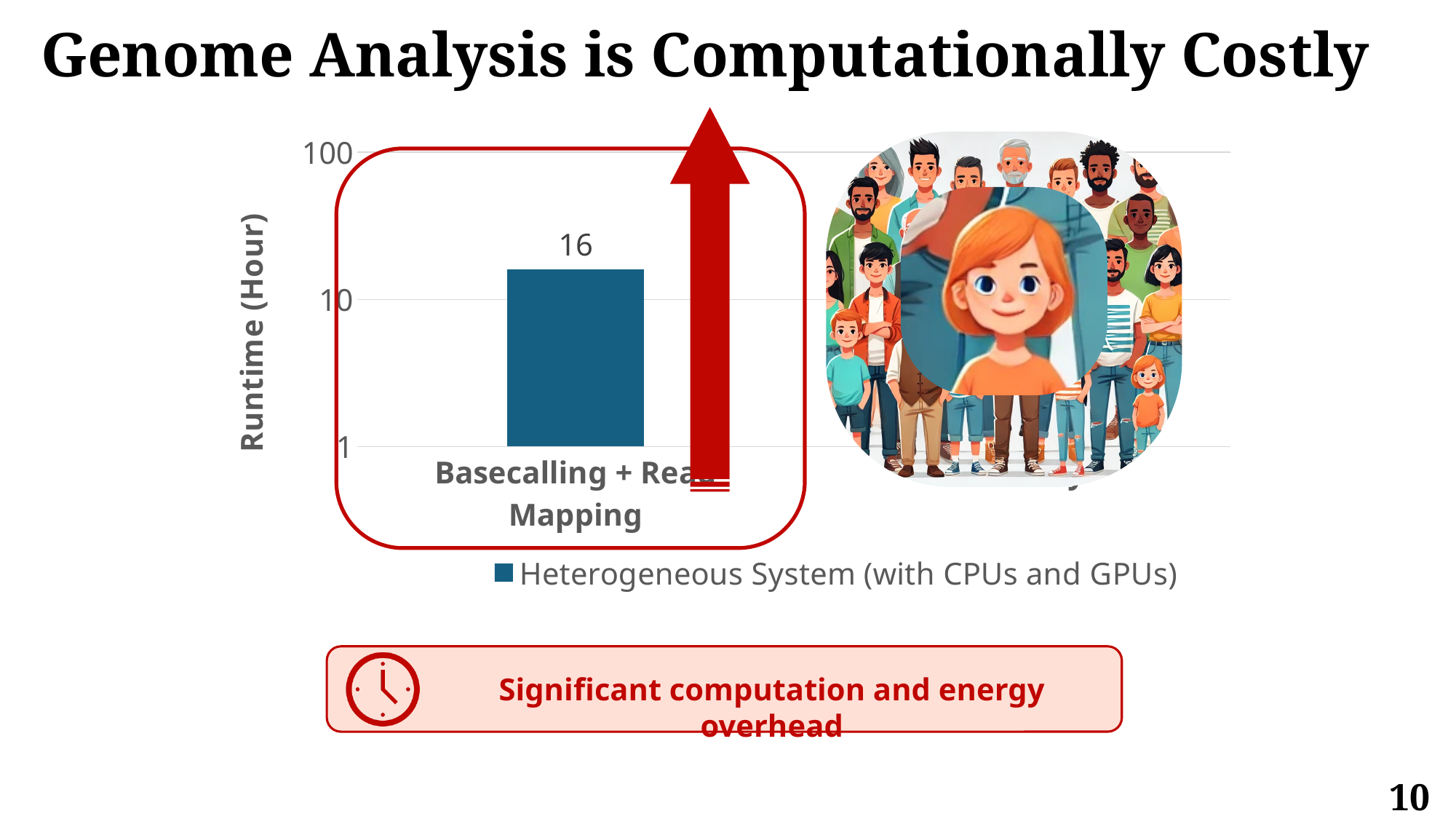
What series name is listed in the chart legend? Heterogeneous System (with CPUs and GPUs) How many series does the chart legend list? 1 What unit is the runtime measured in on the chart's y-axis? Hour What kind of chart is shown on the slide? bar chart Is the value for Basecalling + Read Mapping greater or less than 10? greater What is the runtime value shown for Basecalling + Read Mapping? 16 What is the label of the y-axis of the chart? Runtime (Hour) Is the value for Basecalling + Read Mapping greater or less than 100? less